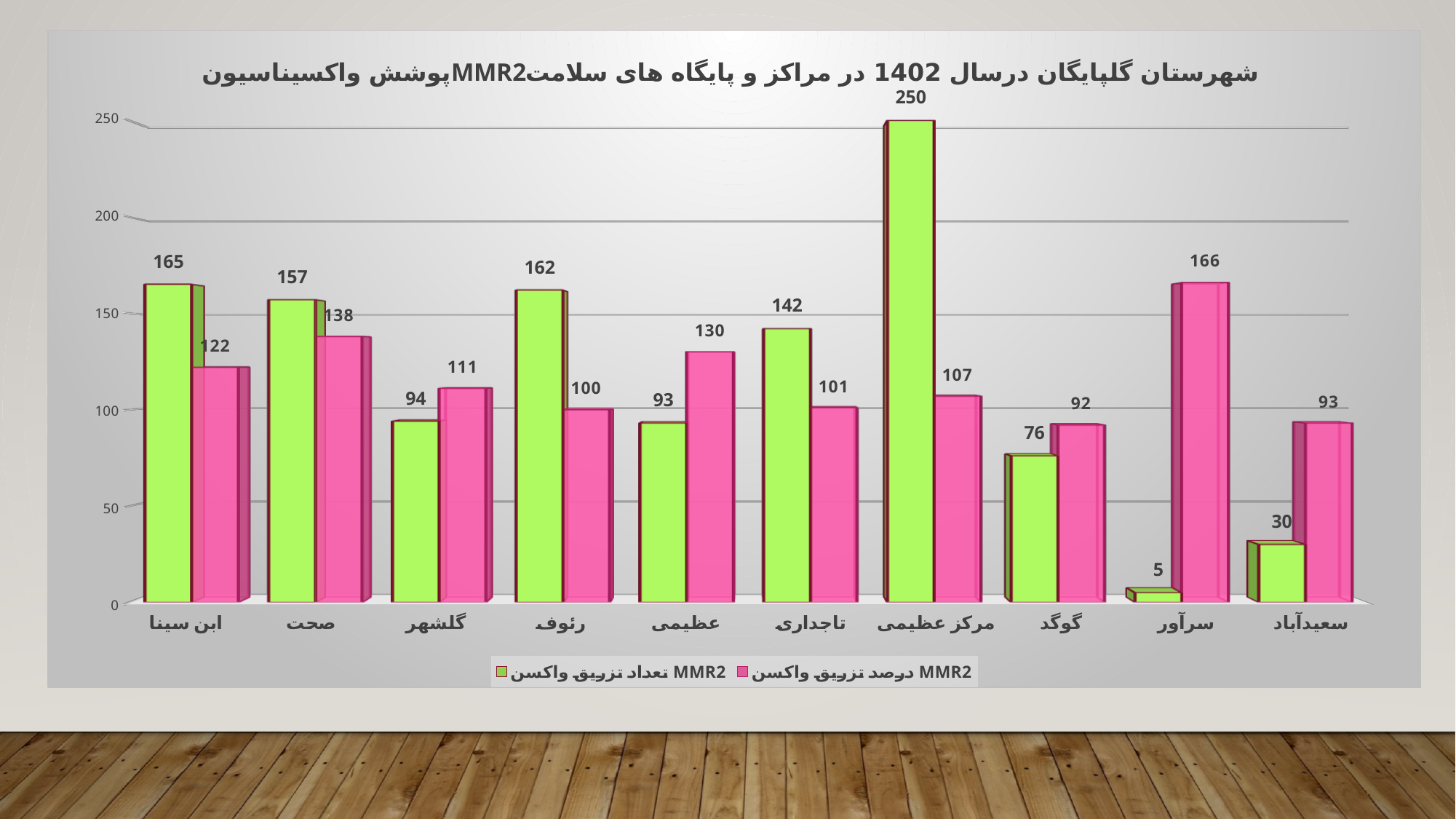
How many series does the legend list? 2 How many categories are shown on the x axis? 10 What is the value of the pink series (درصد تزریق واکسن MMR2) for سرآور? 166 Which category has the highest value in the green series (تعداد تزریق واکسن MMR2)? مرکز عظیمی What is the difference between the green and pink values for ابن سینا? 43 Which category has the lowest value in the pink series (درصد تزریق واکسن MMR2)? گوگد What is the value of the green series (تعداد تزریق واکسن MMR2) for مرکز عظیمی? 250 What is the value of the pink series (درصد تزریق واکسن MMR2) for عظیمی? 130 What is the value of the green series (تعداد تزریق واکسن MMR2) for گلشهر? 94 Which is larger for تاجداری: the green series value or the pink series value? the green series (142) What kind of chart is shown on the slide? bar chart Which category has the lowest value in the green series (تعداد تزریق واکسن MMR2)? سرآور